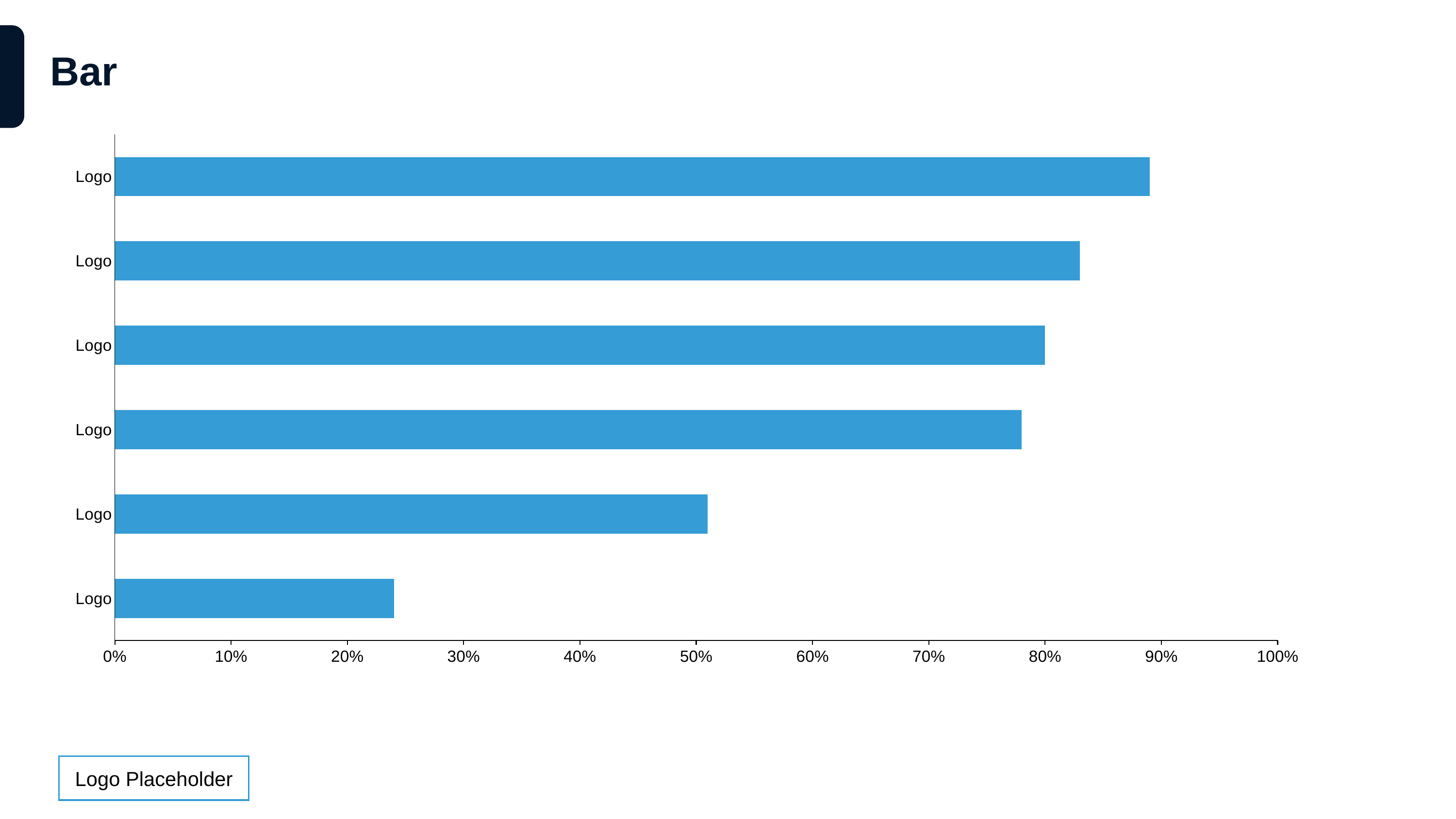
Is the value of the second bar from the top greater or less than 80%? greater How many bars does the chart show? 6 Is the value of the fifth bar from the top greater or less than 60%? less What is the title of the slide? Bar What kind of chart is shown on the slide? bar chart Which is larger, the value of the top bar or the value of the bottom bar? the top bar Is the value of the top bar greater or less than 80%? greater Which bar has the highest value, the top bar or the bottom bar? the top bar Which bar has the lowest value? the bottom bar Do the bar values increase or decrease going from the top bar to the bottom bar? decrease